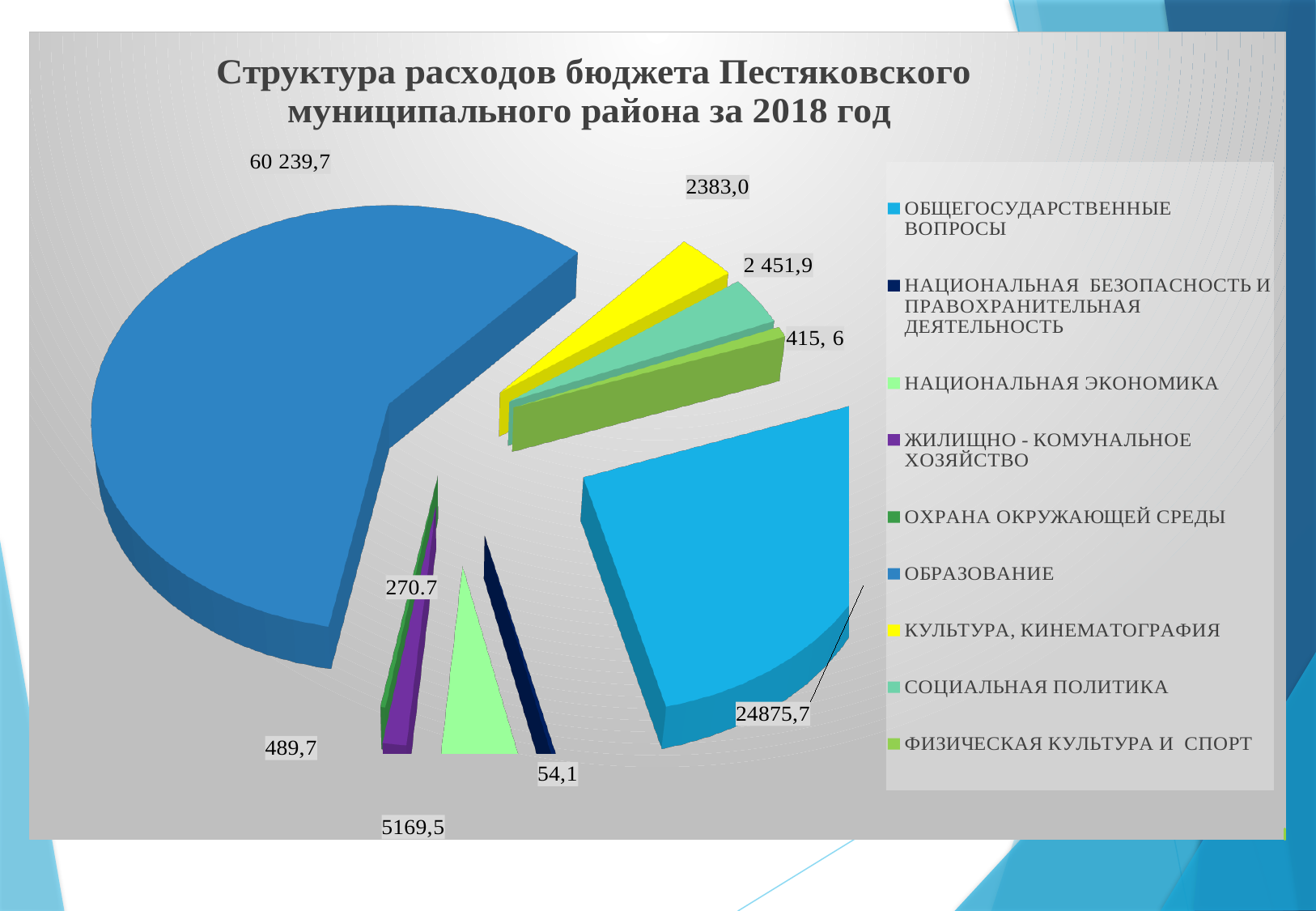
How many categories does the legend of the pie chart list? 9 What value is shown for ОБЩЕГОСУДАРСТВЕННЫЕ ВОПРОСЫ? 24875,7 Which category has the smallest slice of the pie chart? НАЦИОНАЛЬНАЯ БЕЗОПАСНОСТЬ И ПРАВОХРАНИТЕЛЬНАЯ ДЕЯТЕЛЬНОСТЬ What kind of chart is shown on the slide? Pie chart What is the title of the chart? Структура расходов бюджета Пестяковского муниципального района за 2018 год What value is shown for ОБРАЗОВАНИЕ? 60 239,7 Which category has the largest slice of the pie chart? ОБРАЗОВАНИЕ Which is larger, the value for ОБРАЗОВАНИЕ or the value for ОБЩЕГОСУДАРСТВЕННЫЕ ВОПРОСЫ? ОБРАЗОВАНИЕ What is the difference between the values for ОБРАЗОВАНИЕ (60 239,7) and ОБЩЕГОСУДАРСТВЕННЫЕ ВОПРОСЫ (24875,7)? 35364,0 What colour is the slice for КУЛЬТУРА, КИНЕМАТОГРАФИЯ? Yellow What value is shown for НАЦИОНАЛЬНАЯ ЭКОНОМИКА? 5169,5 What value is shown for КУЛЬТУРА, КИНЕМАТОГРАФИЯ? 2383,0